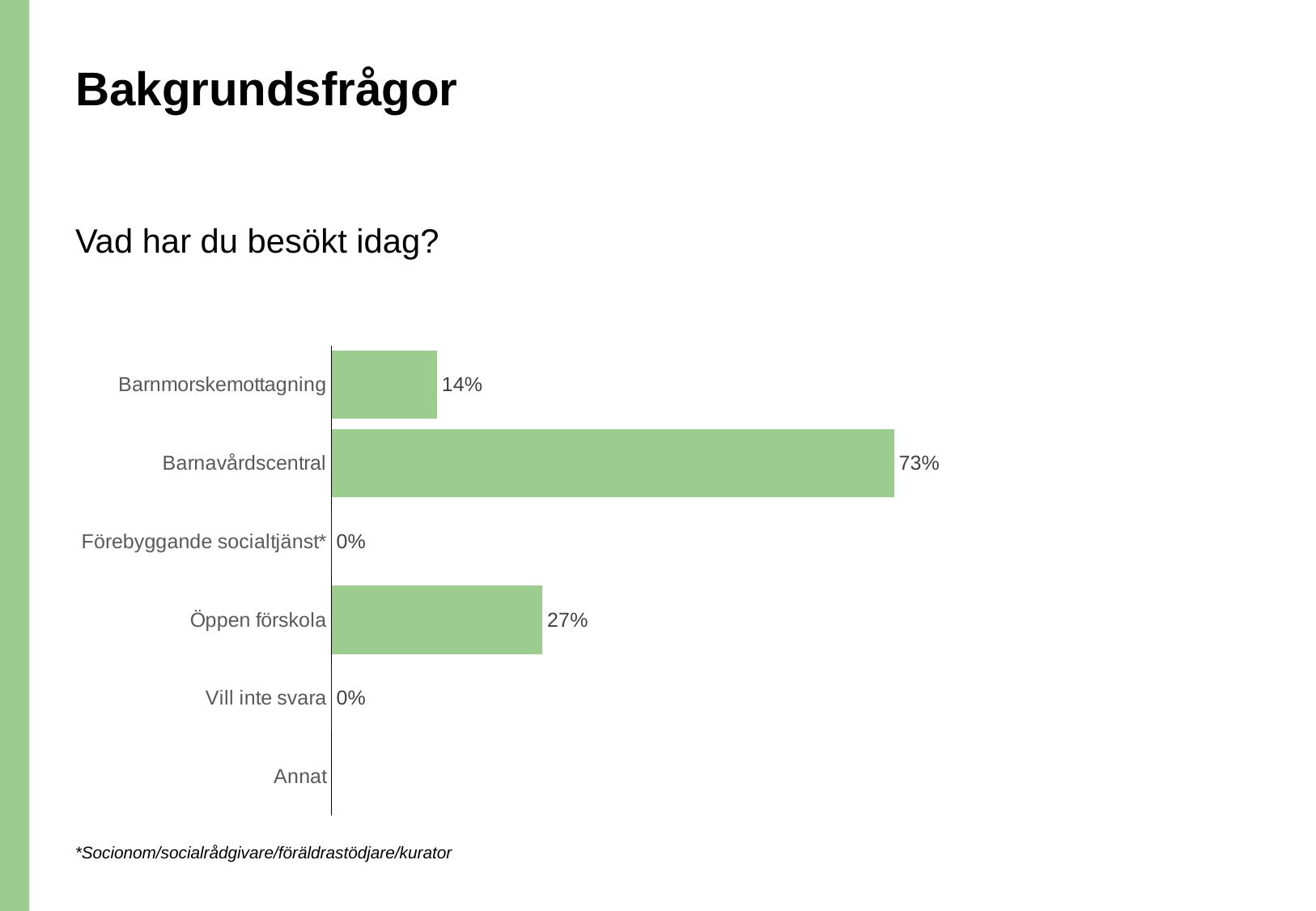
What is the value for Barnavårdscentral? 73% What kind of chart is shown on the slide? Bar chart Which is larger, the value for Öppen förskola or the value for Barnmorskemottagning? Öppen förskola What is the value for Öppen förskola? 27% What question does the chart answer, according to the text above it? Vad har du besökt idag? How many categories are shown on the chart? 6 What is the value for Vill inte svara? 0% What is the difference between the values for Barnavårdscentral and Öppen förskola? 46% What is the value for Förebyggande socialtjänst*? 0% What is the difference between the values for Öppen förskola and Barnmorskemottagning? 13% What is the value for Barnmorskemottagning? 14% Which category has the highest value? Barnavårdscentral